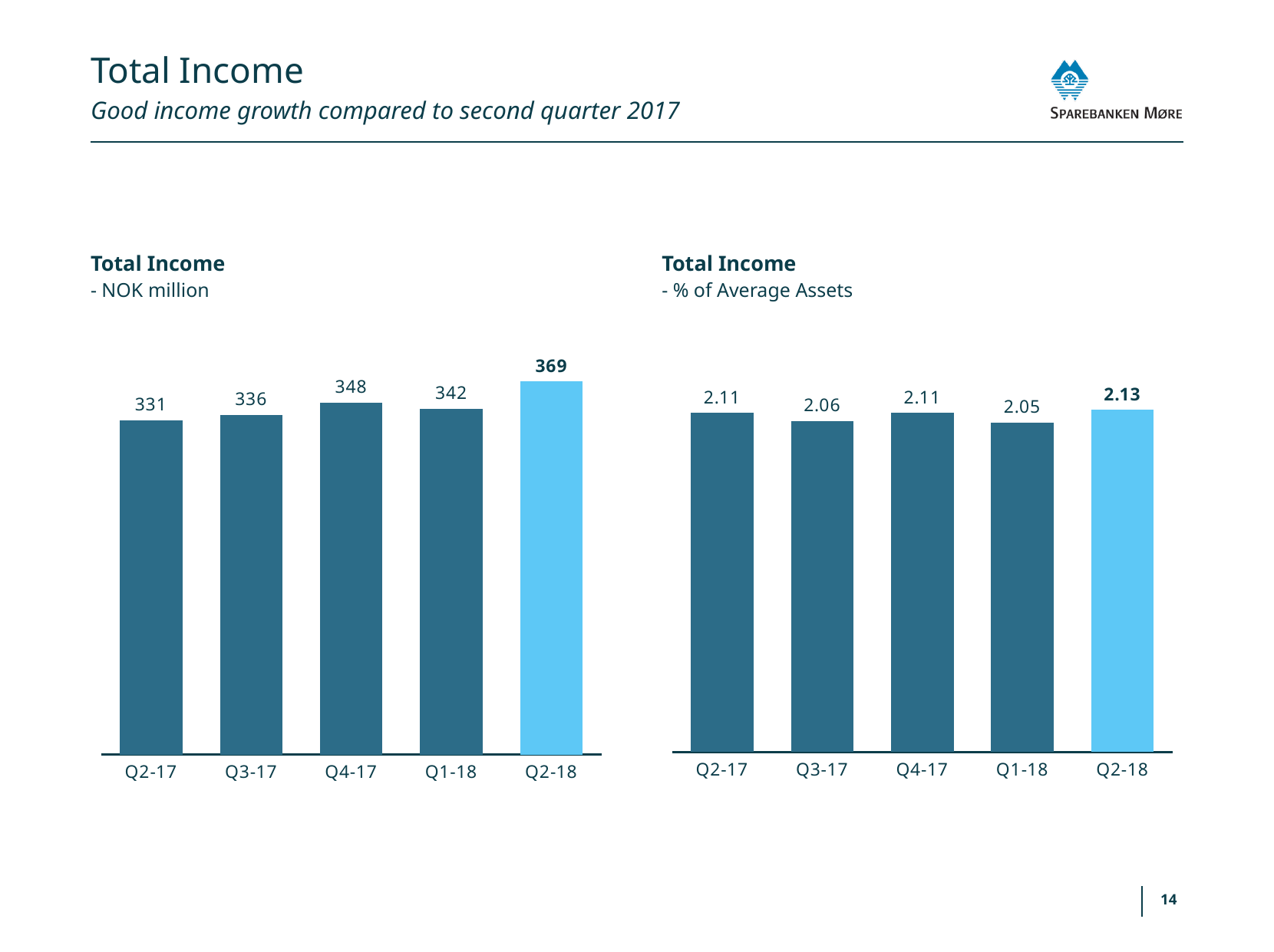
In the right chart (Total Income - % of Average Assets), what is the value for Q1-18? 2.05 In the left chart (Total Income - NOK million), which quarter has the lowest value? Q2-17 In the right chart (Total Income - % of Average Assets), what is the difference between Q2-18 and Q1-18? 0.08 In the left chart (Total Income - NOK million), what is the value for Q2-18? 369 In the left chart (Total Income - NOK million), which bar is shown in a lighter blue colour than the others? Q2-18 What type of chart is the left chart (Total Income - NOK million)? Bar chart In the left chart (Total Income - NOK million), what is the difference between Q2-18 and Q2-17? 38 In the right chart (Total Income - % of Average Assets), which quarter has the highest value? Q2-18 In the left chart (Total Income - NOK million), how many quarters are shown? 5 In the left chart (Total Income - NOK million), which is larger, Q4-17 or Q1-18? Q4-17 In the right chart (Total Income - % of Average Assets), what is the value for Q3-17? 2.06 In the left chart (Total Income - NOK million), what is the value for Q4-17? 348